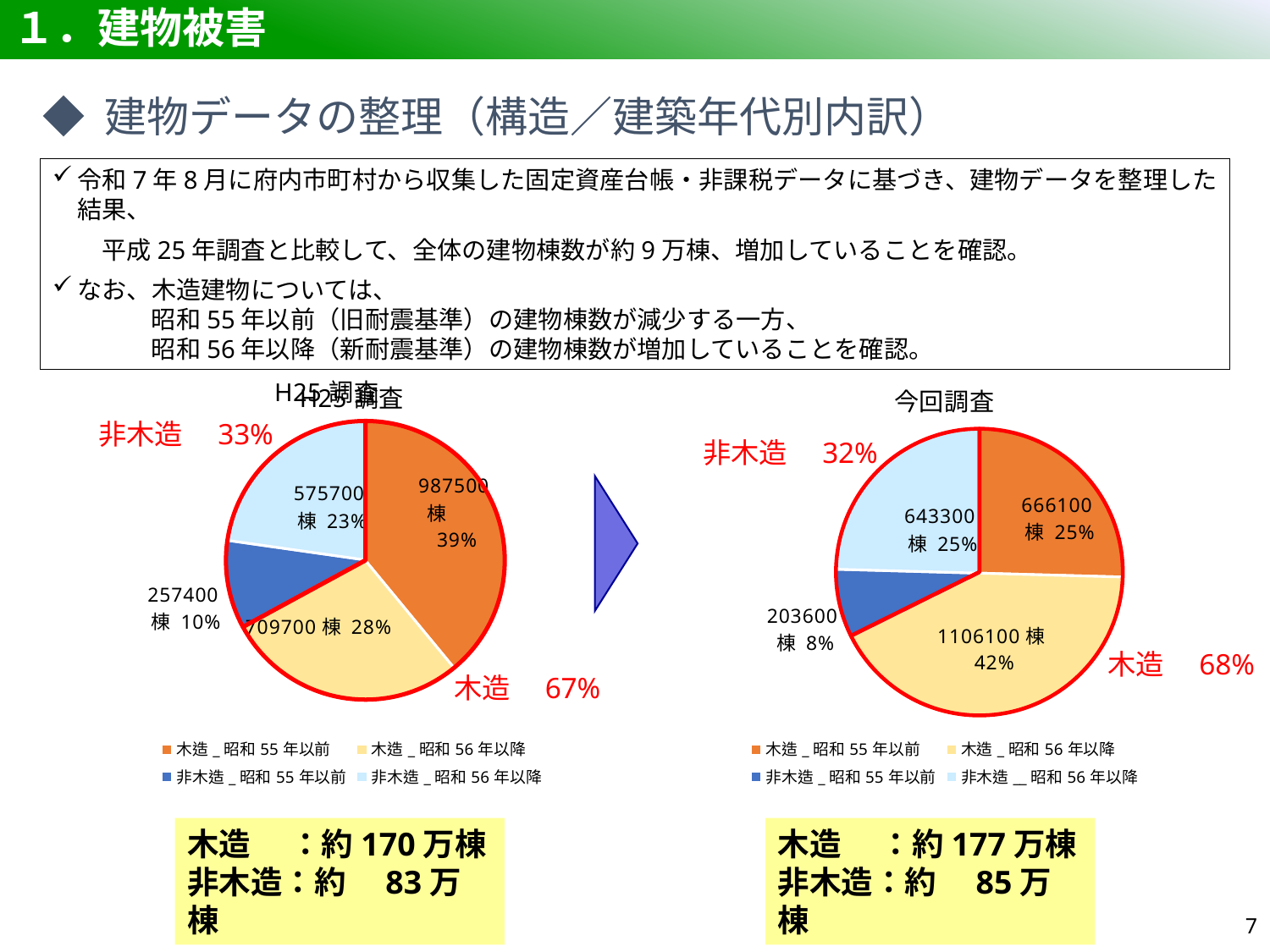
In the 今回調査 pie chart, what is the difference in 棟 between 木造_昭和56年以降 and 木造_昭和55年以前? 440000棟 In the 今回調査 pie chart, what percentage is shown for 非木造_昭和55年以前? 8% In the 今回調査 pie chart, which category has the smallest slice? 非木造_昭和55年以前 In the H25調査 pie chart, how many 棟 are shown for 木造_昭和55年以前? 987500棟 In the H25調査 pie chart, what is the total 棟 for the two 木造 categories combined? 1697200棟 What type of chart is used for 今回調査? Pie chart In the H25調査 pie chart, what percentage is shown for 非木造_昭和56年以降? 23% In the 今回調査 pie chart, how many 棟 are shown for 木造_昭和56年以降? 1106100棟 In the H25調査 pie chart, which is larger: 木造_昭和56年以降 or 非木造_昭和56年以降? 木造_昭和56年以降 How many slices does the 今回調査 pie chart have? 4 How many entries does the legend of the H25調査 pie chart list? 4 In the H25調査 pie chart, which category has the largest slice? 木造_昭和55年以前